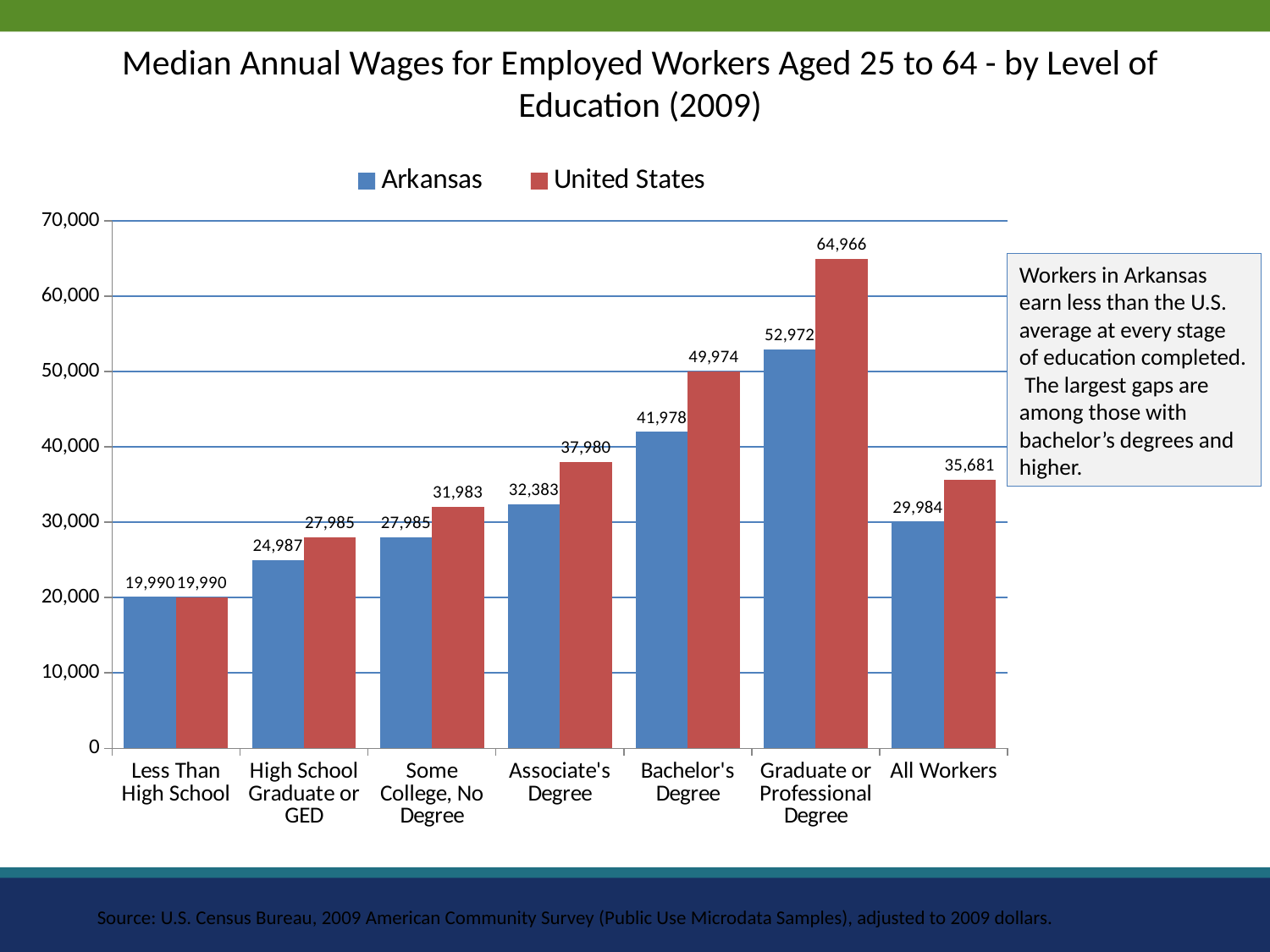
How many education categories are shown on the x axis? 7 Which is larger, the Arkansas median wage for Some College, No Degree or the Arkansas median wage for Associate's Degree? Associate's Degree What kind of chart is shown on the slide? Bar chart Which education level has the highest median annual wage for the United States? Graduate or Professional Degree Is the United States median annual wage for Bachelor's Degree greater or less than 50,000? less Which education level has the lowest median annual wage for Arkansas? Less Than High School What is the difference between the United States and Arkansas median annual wages for workers with a Graduate or Professional Degree? 11,994 What is the difference between the United States and Arkansas median annual wages for All Workers? 5,697 What is the median annual wage for Arkansas workers with a Bachelor's Degree? 41,978 What is the median annual wage for United States workers with a Graduate or Professional Degree? 64,966 What is the median annual wage for All Workers in Arkansas? 29,984 How many series does the legend list? 2